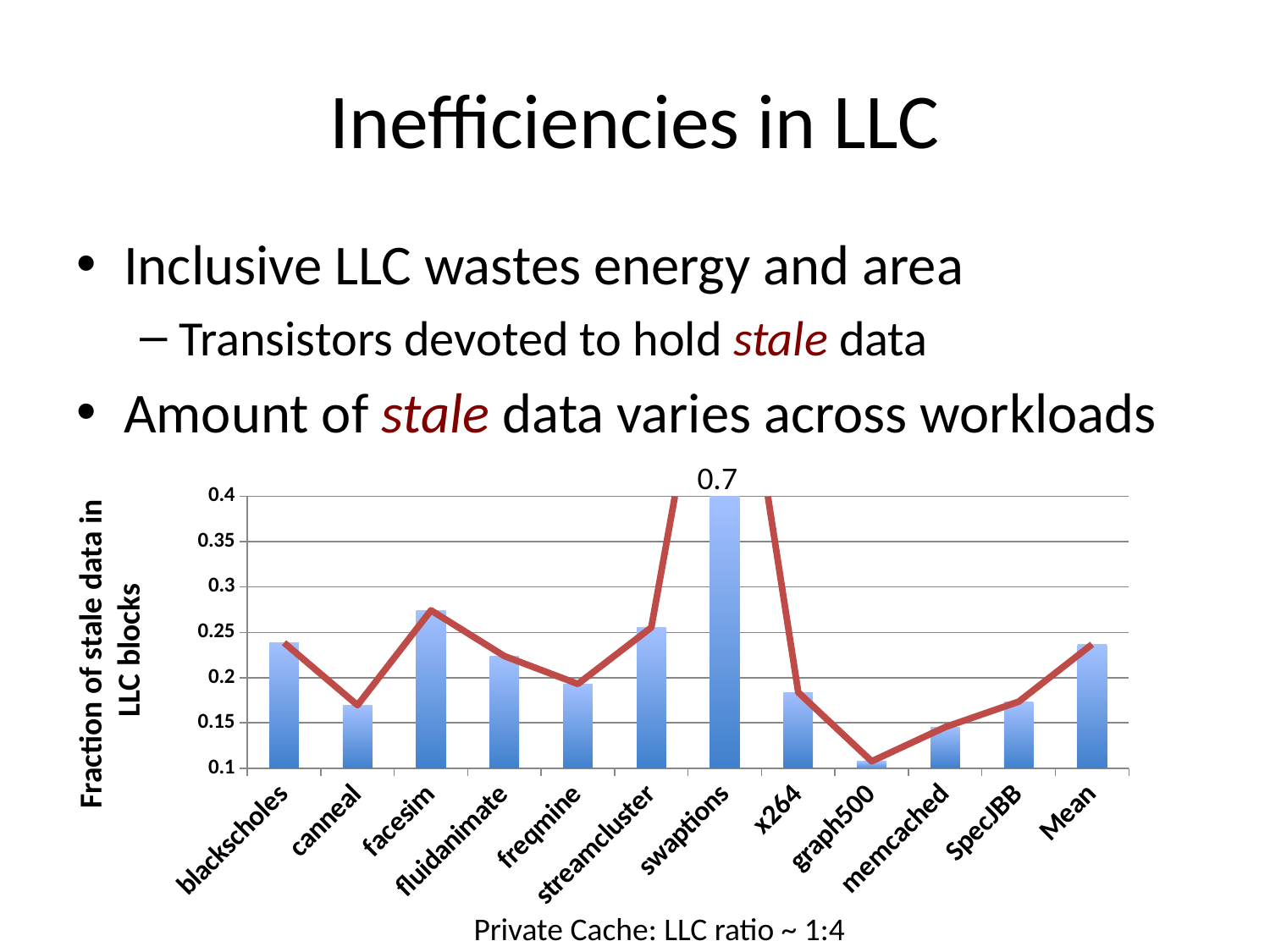
How many categories are shown on the x axis? 12 What is the value for swaptions? 0.7 Which has a larger value, facesim or canneal? facesim Is the value for graph500 greater or less than 0.15? less What is the label of the y axis? Fraction of stale data in LLC blocks Which workload has the highest fraction of stale data? swaptions Which workload has the lowest fraction of stale data? graph500 Is the value for canneal greater or less than 0.2? less Is the value for facesim greater or less than 0.25? greater What kind of chart is shown on the slide? combination bar and line chart Which has a larger value, blackscholes or memcached? blackscholes